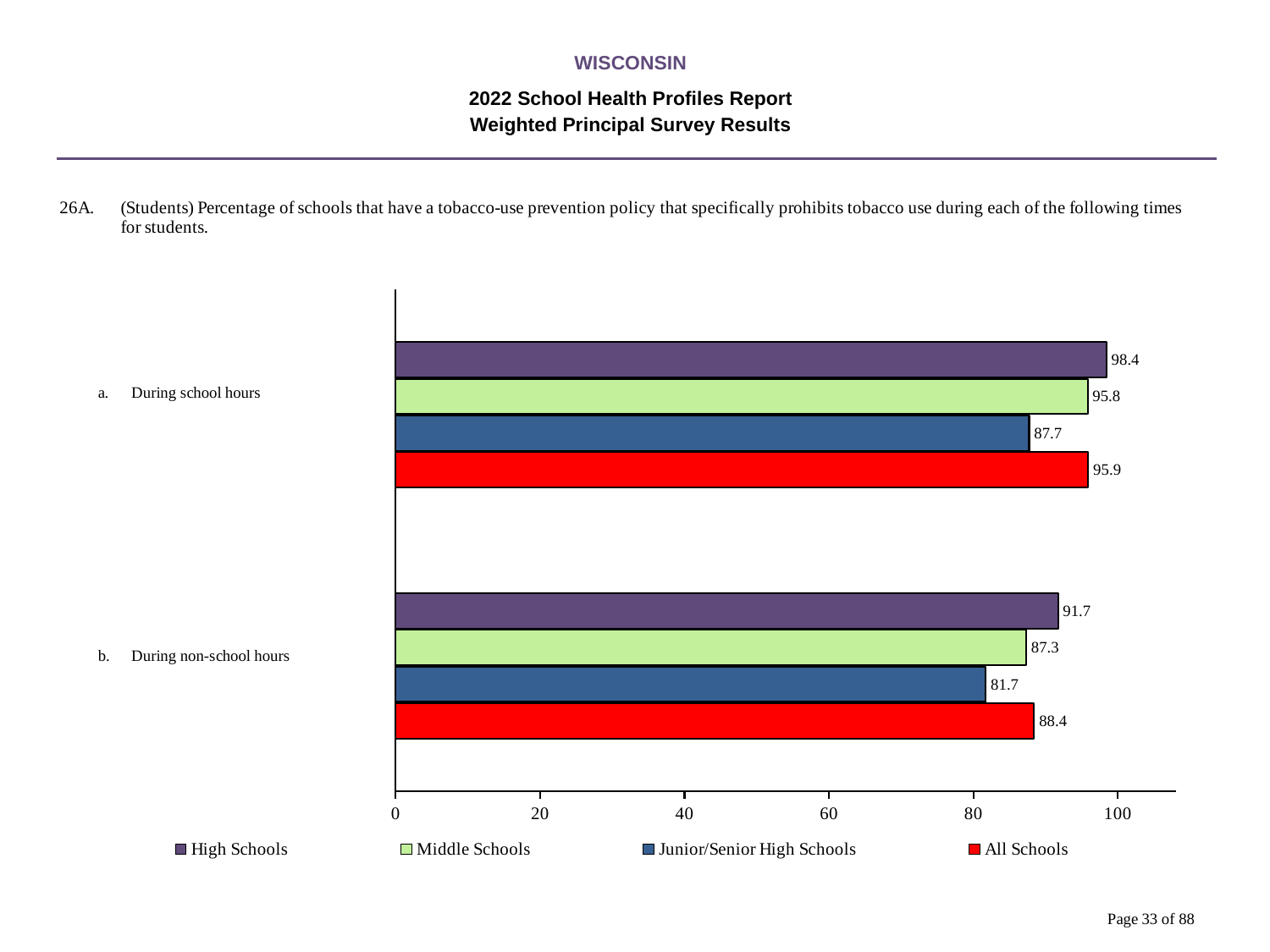
What is the value for All Schools during school hours? 95.9 What is the value for Junior/Senior High Schools during non-school hours? 81.7 What is the value for High Schools during school hours? 98.4 What colour represents All Schools in the legend? Red How many categories are shown on the chart? 2 What is the value for Middle Schools during non-school hours? 87.3 Which is larger: the Middle Schools value during school hours or the All Schools value during school hours? All Schools Which school type has the highest value during non-school hours? High Schools What kind of chart is shown on the slide? Bar chart How many series does the legend list? 4 Which school type has the lowest value during school hours? Junior/Senior High Schools What is the difference between the High Schools values for during school hours and during non-school hours? 6.7